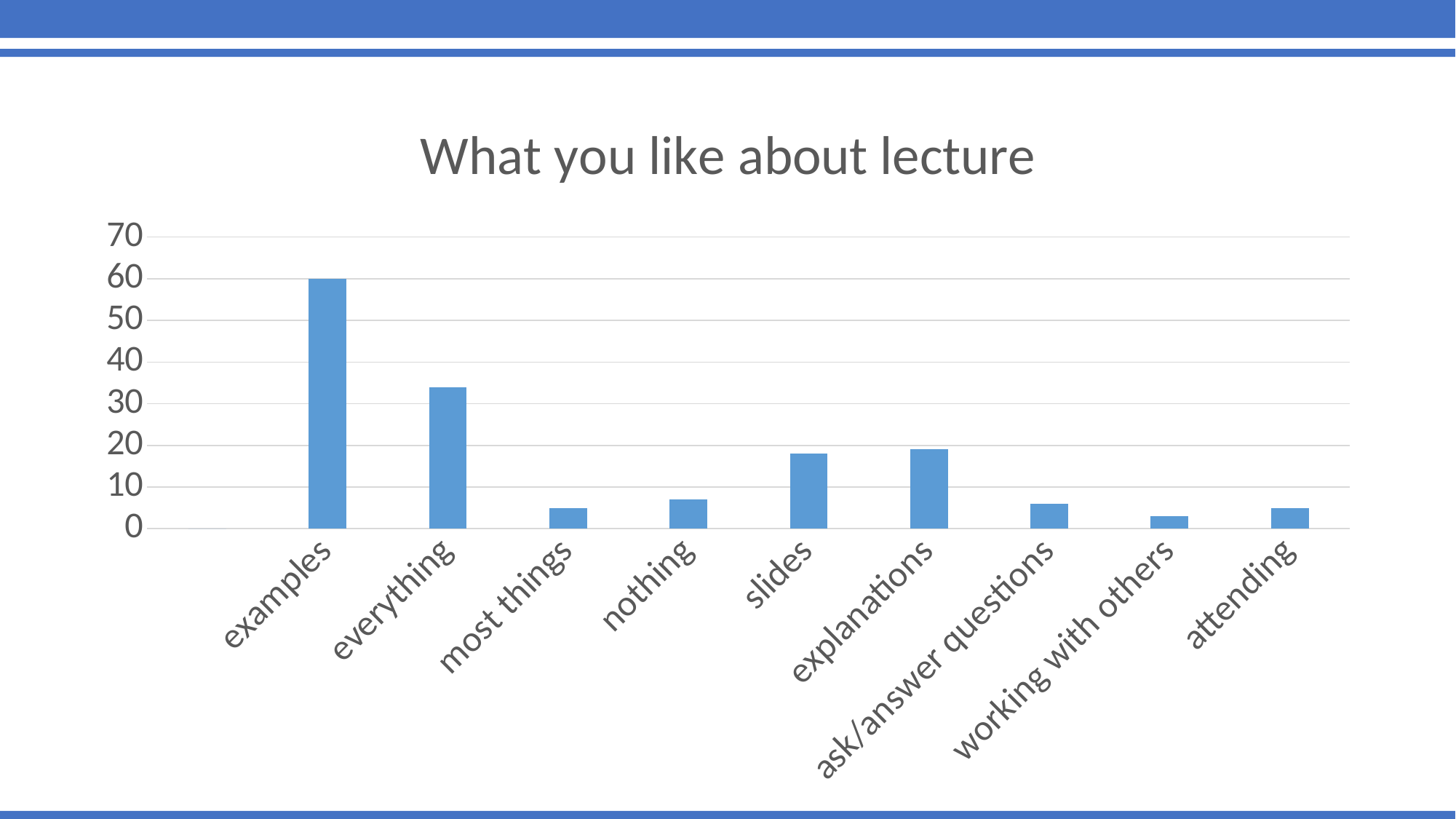
Is the value for nothing greater or less than 10? less Which category has the highest value? examples Which is larger, the value for examples or the value for everything? examples What is the value for examples? 60 Is the value for everything greater or less than 40? less Is the value for everything greater or less than 30? greater What is the title of the chart? What you like about lecture Which is larger, the value for slides or the value for nothing? slides How many categories are shown on the x axis of the chart? 9 What kind of chart is shown on the slide? bar chart Which category has the lowest value? working with others